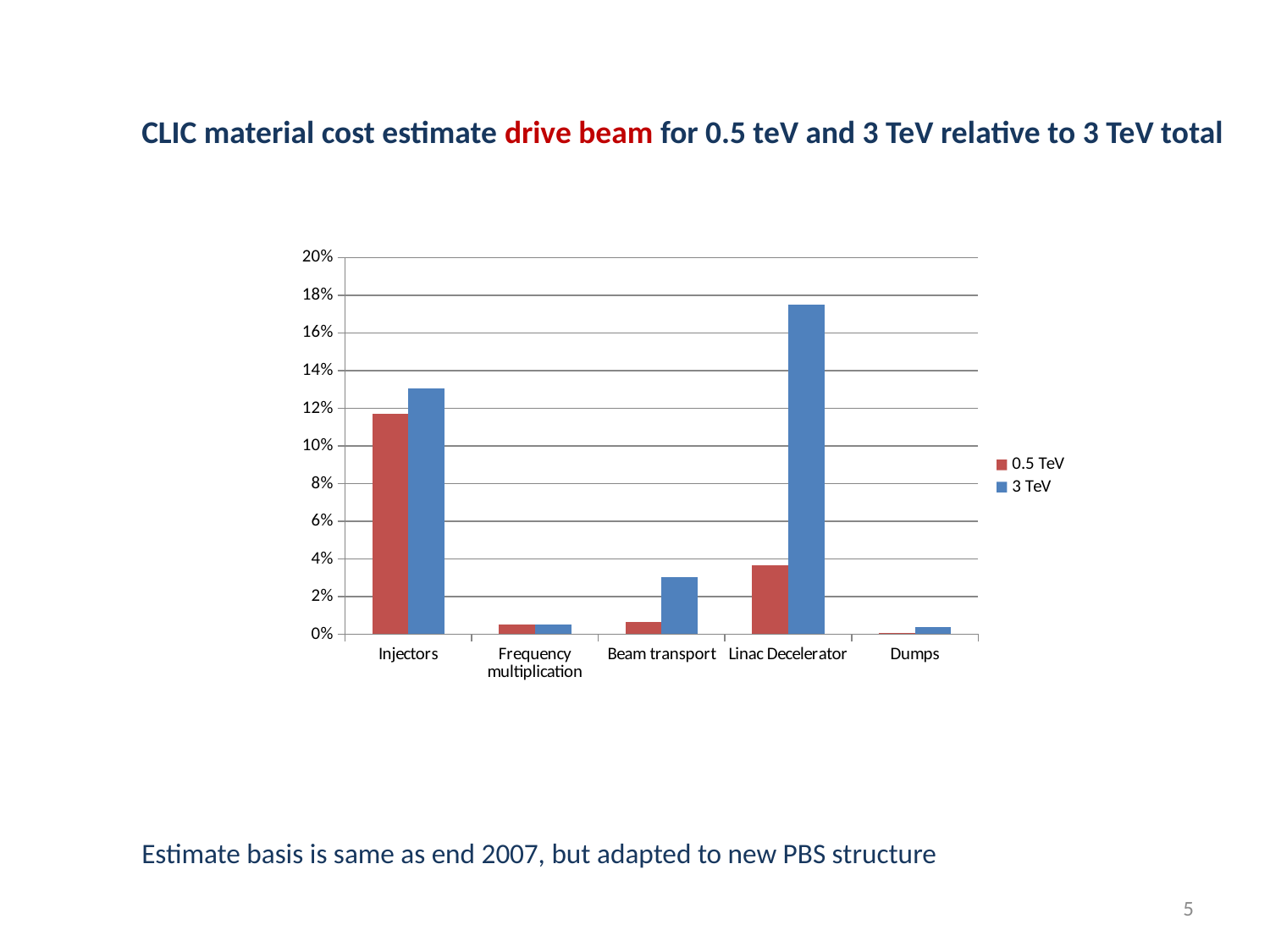
Which colour represents the 3 TeV series in the chart? blue Is the 0.5 TeV value for Injectors greater or less than 10%? greater Is the 3 TeV value for Linac Decelerator greater or less than 16%? greater Is the 0.5 TeV value for Linac Decelerator greater or less than 4%? less What kind of chart is shown on the slide? bar chart Which category has the highest value for the 0.5 TeV series? Injectors Which category has the lowest value for the 0.5 TeV series? Dumps Which category has the highest value for the 3 TeV series? Linac Decelerator For Injectors, which series has the larger value, 0.5 TeV or 3 TeV? 3 TeV How many series does the legend list? 2 How many categories are shown on the x axis? 5